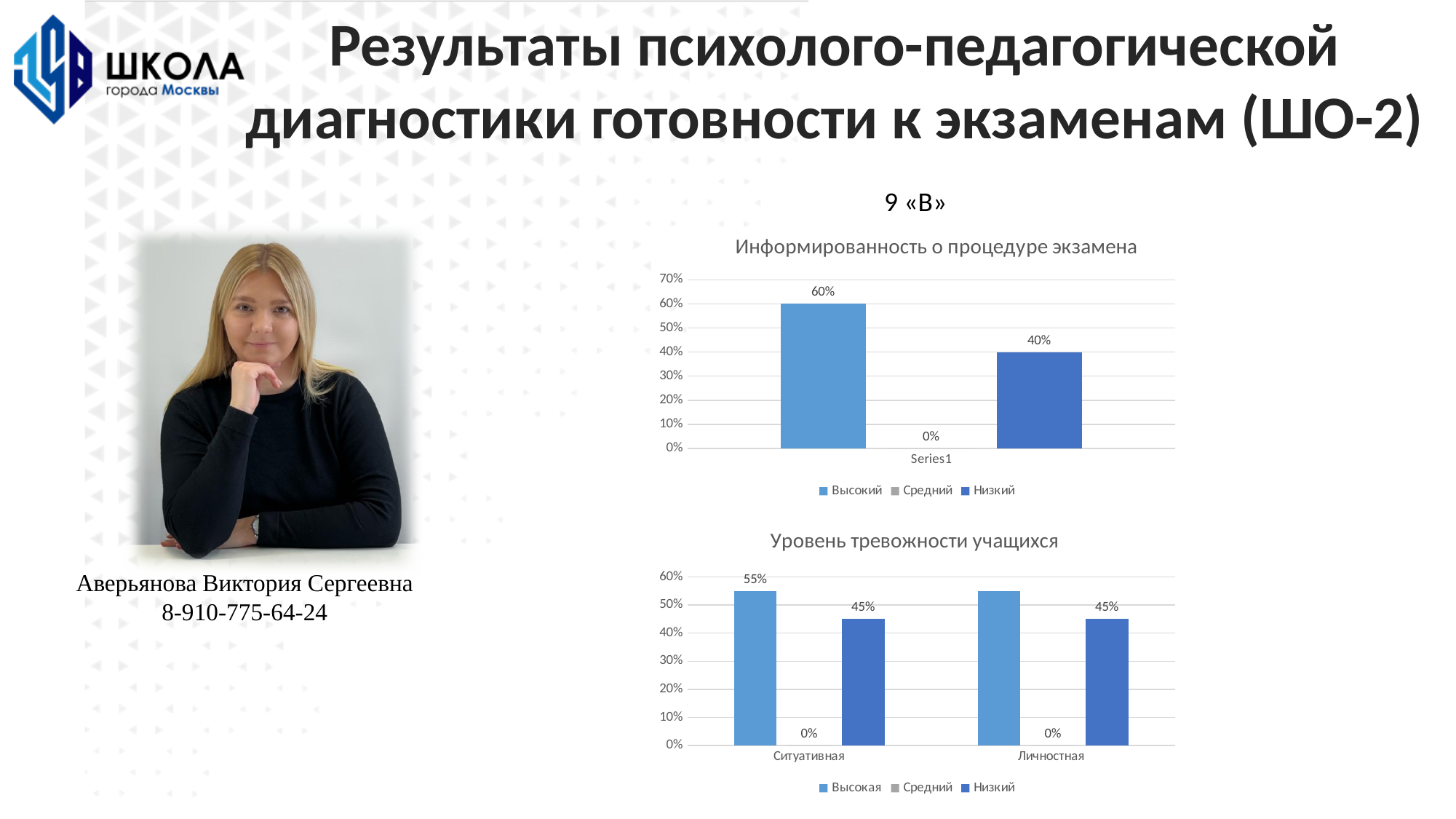
In the chart titled "Уровень тревожности учащихся", what is the value for Средний in the Ситуативная category? 0% In the chart titled "Информированность о процедуре экзамена", what is the value for Высокий? 60% In the chart titled "Уровень тревожности учащихся", what is the value for Низкий in the Личностная category? 45% In the chart titled "Информированность о процедуре экзамена", how many series does the legend list? 3 In the chart titled "Уровень тревожности учащихся", which is larger in the Ситуативная category: Высокая or Низкий? Высокая What kind of chart is the chart titled "Уровень тревожности учащихся"? bar chart In the chart titled "Уровень тревожности учащихся", how many categories are shown on the x axis? 2 In the chart titled "Уровень тревожности учащихся", what is the value for Высокая in the Ситуативная category? 55% In the chart titled "Уровень тревожности учащихся", is the value for Высокая in the Личностная category greater or less than 50%? greater In the chart titled "Информированность о процедуре экзамена", what is the difference between the Высокий and Низкий values? 20% In the chart titled "Информированность о процедуре экзамена", which series has the highest value? Высокий In the chart titled "Информированность о процедуре экзамена", what is the value for Низкий? 40%